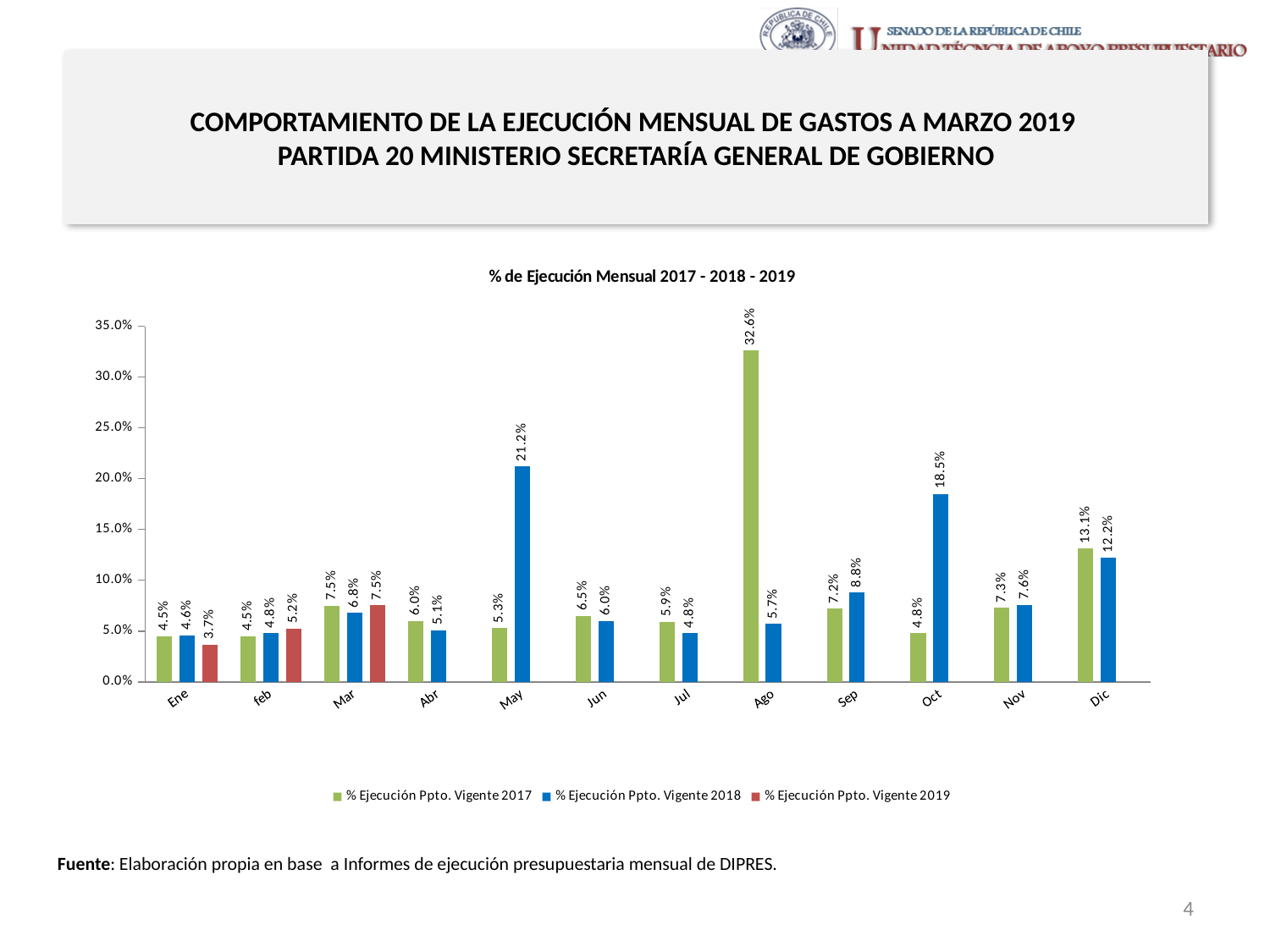
In which month is the 2017 series (% Ejecución Ppto. Vigente 2017) highest? Ago How many months are shown on the x axis? 12 What is the value for the 2017 series (% Ejecución Ppto. Vigente 2017) in Dic? 13.1% What is the difference between the 2017 and 2018 values in Oct? 13.7% Which is larger in Sep: the 2017 value or the 2018 value? 2018 value (8.8%) In which month is the 2018 series (% Ejecución Ppto. Vigente 2018) lowest? Ene What is the value for the 2018 series (% Ejecución Ppto. Vigente 2018) in May? 21.2% Is the 2017 value for Ago greater or less than 30.0%? greater What kind of chart is shown on the slide? Bar chart What is the title of the chart? % de Ejecución Mensual 2017 - 2018 - 2019 How many series does the legend list? 3 What is the value for the 2019 series (% Ejecución Ppto. Vigente 2019) in Ene? 3.7%